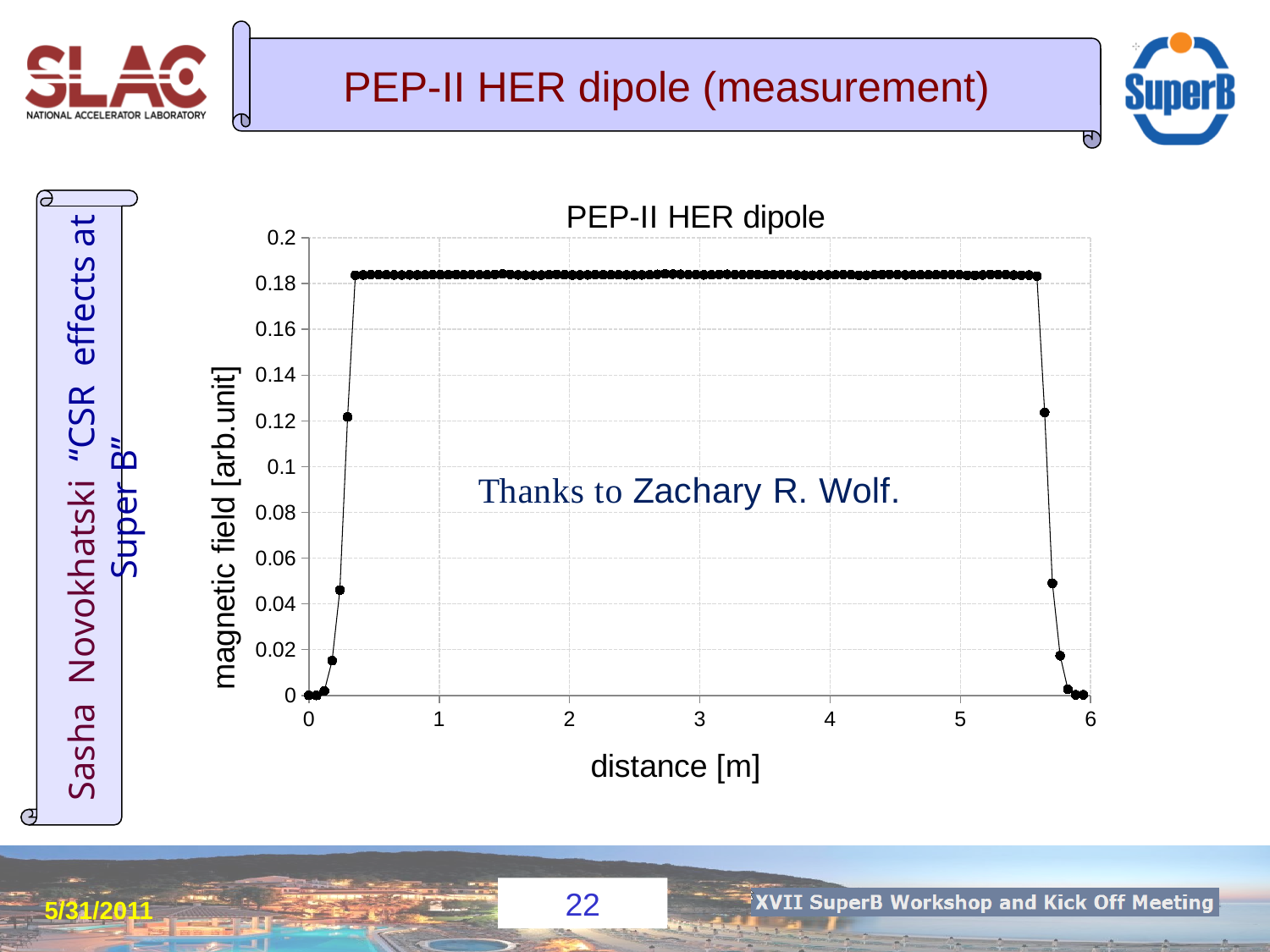
Does the magnetic field ever exceed 0.2 on the chart? no Which has the larger magnetic field value, the point at 0 m or the point at 2 m? 2 m How does the magnetic field change as distance increases from 5 m to 6 m? it falls Is the magnetic field value at a distance of 1 m greater or less than 0.1? greater How does the magnetic field change as distance increases from 0 m to 1 m? it rises What is the title of the chart? PEP-II HER dipole What kind of chart is shown on the slide? scatter chart What is the label of the y axis? magnetic field [arb.unit] Is the magnetic field value at a distance of 3 m greater or less than 0.16? greater Which has the larger magnetic field value, the point at 4 m or the point at 6 m? 4 m